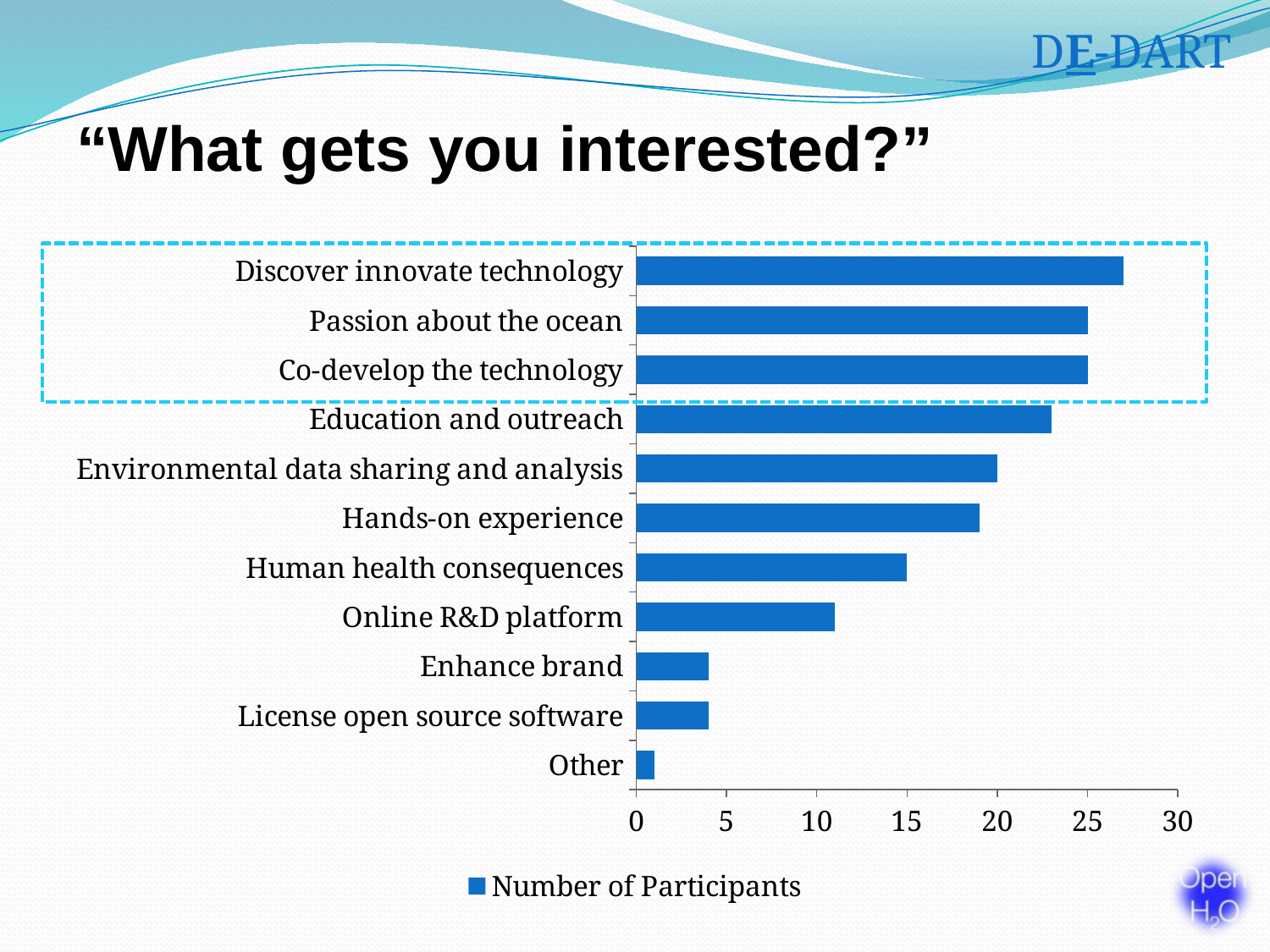
Is the value for Discover innovate technology greater or less than 25? greater What series name is shown in the legend? Number of Participants How many categories are plotted in the chart? 11 How many series does the legend list? 1 What is the number of participants for Environmental data sharing and analysis? 20 What kind of chart is shown on the slide? Bar chart What is the number of participants for Human health consequences? 15 Which category has the lowest number of participants? Other Is the value for Enhance brand greater or less than 5? less Which category has the highest number of participants? Discover innovate technology Is the value for Online R&D platform greater or less than 10? greater Which has more participants, Education and outreach or Hands-on experience? Education and outreach